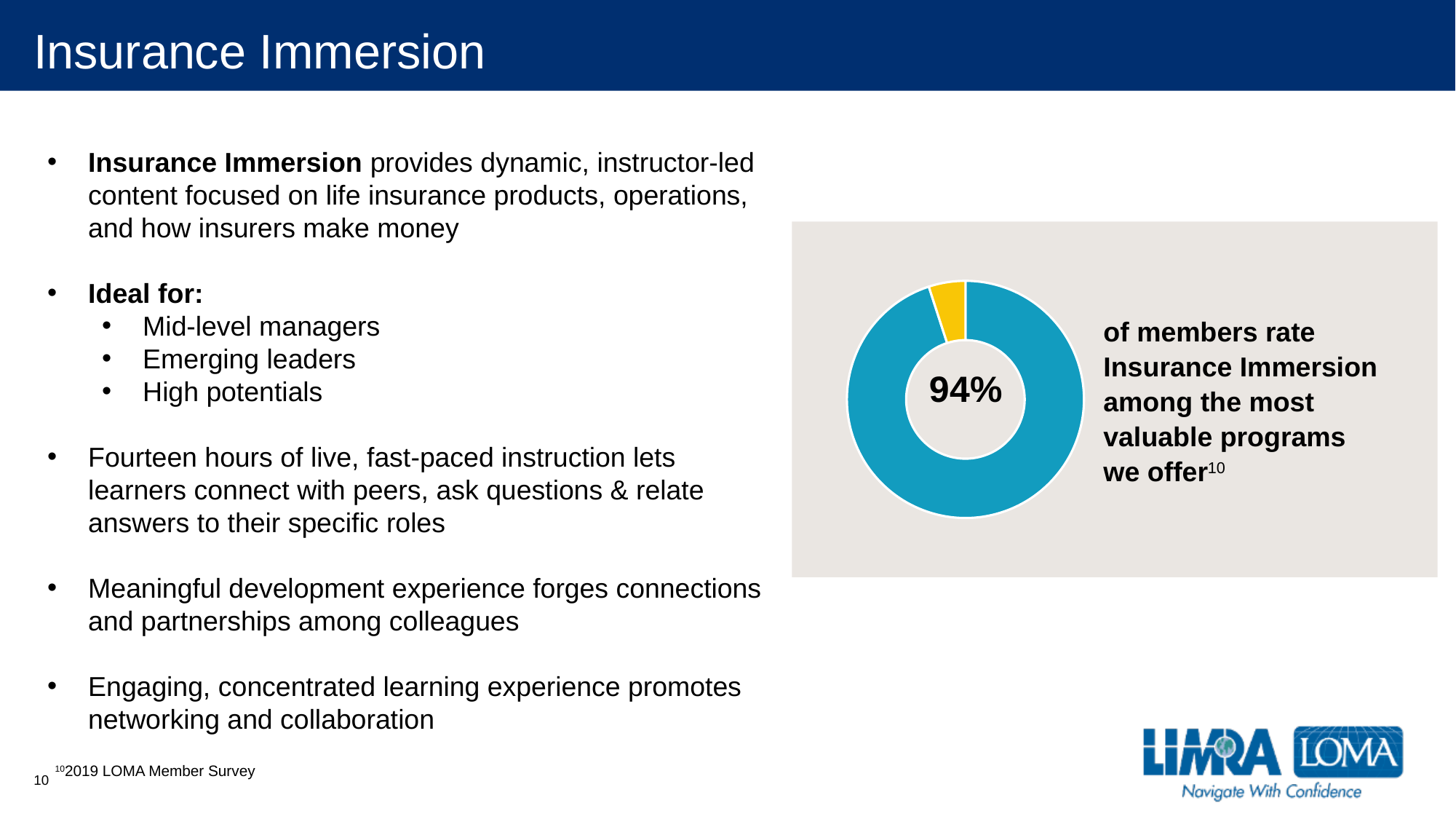
Which slice of the donut chart is larger, the blue one or the yellow one? the blue one What colour is the largest slice of the donut chart? blue What percentage is printed in the center of the donut chart? 94% Which slice of the donut chart is the smallest? the yellow slice According to the text next to the donut chart, what does the 94% represent? members who rate Insurance Immersion among the most valuable programs offered What share of the donut chart does the blue slice represent? 94% Is the value shown in the donut chart greater or less than 50%? greater How many slices does the donut chart have? 2 What kind of chart is shown on the slide? pie chart (donut)